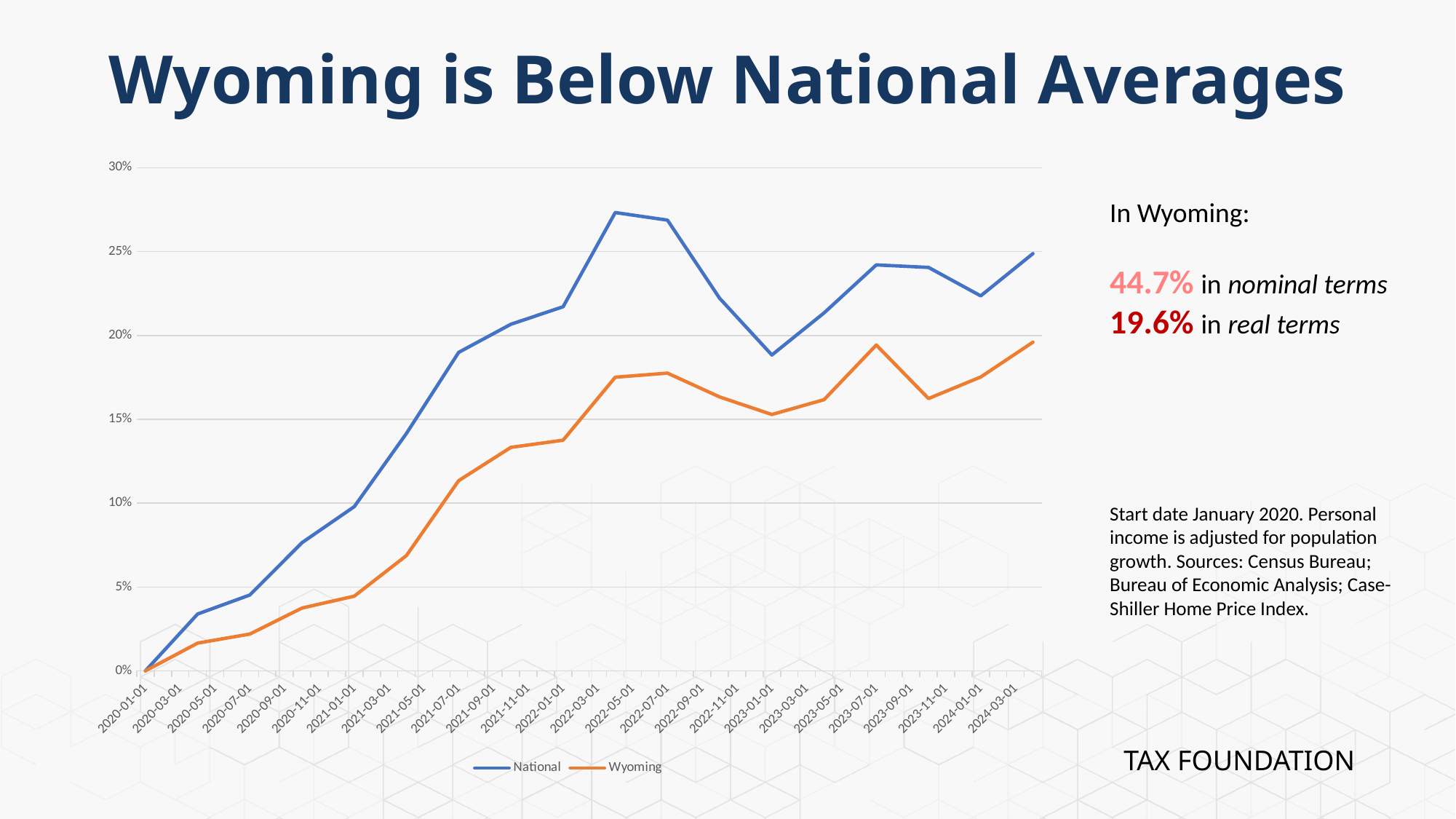
Is the National value at 2023-01-01 greater or less than 20%? less What is the title of the slide containing the chart? Wyoming is Below National Averages Is the National value at 2022-05-01 greater or less than 25%? greater Is the Wyoming value at 2021-01-01 greater or less than 5%? less What kind of chart is shown on the slide? line chart At 2024-03-01, which series has the higher value, National or Wyoming? National How many series does the chart legend list? 2 What are the two series named in the chart legend? National and Wyoming Overall, do the National and Wyoming lines rise or fall from 2020-01-01 to 2024-03-01? rise